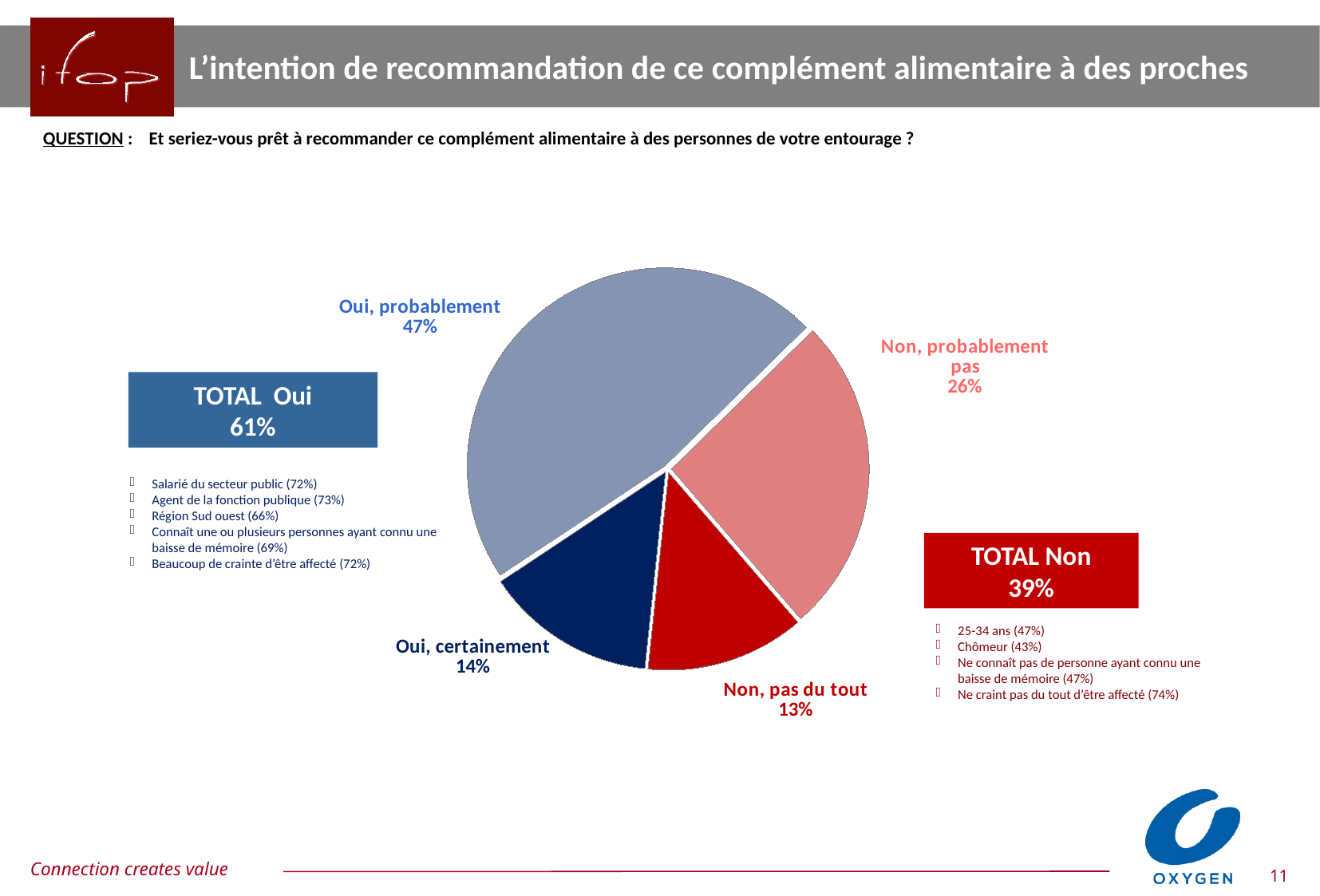
What share of respondents answered "Oui, probablement"? 47% How many slices does the pie chart have? 4 What is the TOTAL Oui percentage shown on the slide? 61% What is the difference between the "Oui, probablement" and "Non, probablement pas" shares? 21% Which is larger, the share for "Oui, probablement" or for "Non, probablement pas"? Oui, probablement What share of respondents answered "Non, probablement pas"? 26% Which slice of the pie is the smallest? Non, pas du tout What is the TOTAL Non percentage shown on the slide? 39% Which slice of the pie is the largest? Oui, probablement What share of respondents answered "Non, pas du tout"? 13% What share of respondents answered "Oui, certainement"? 14% What kind of chart is shown on the slide? pie chart